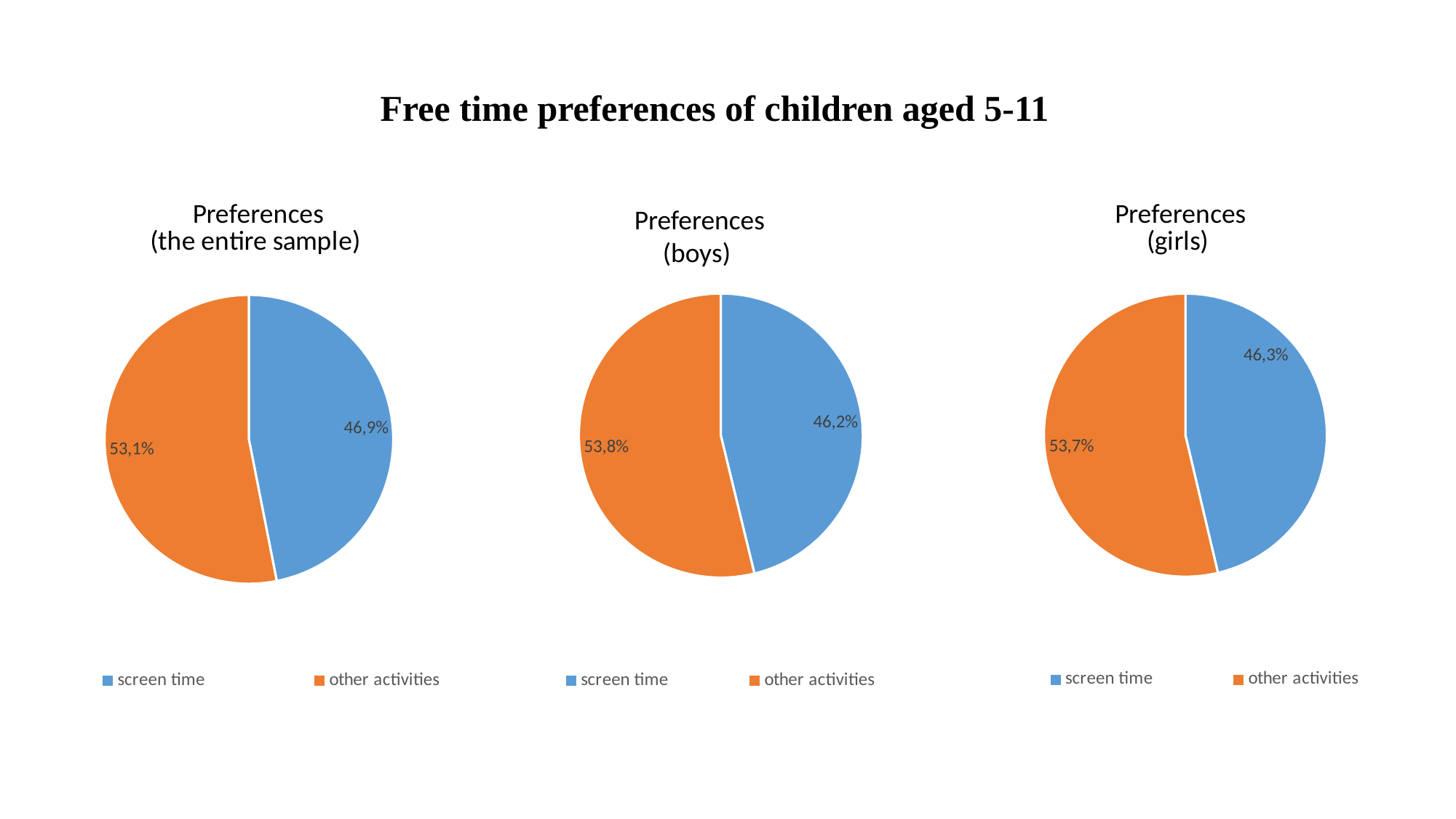
In the 'Preferences (the entire sample)' chart, what share is labelled for other activities? 53,1% In the 'Preferences (girls)' chart, what share is labelled for screen time? 46,3% In the 'Preferences (girls)' chart, which category has the smallest slice? screen time In the 'Preferences (girls)' chart, what share is labelled for other activities? 53,7% In the 'Preferences (boys)' chart, which slice is larger, screen time or other activities? other activities How many slices does the 'Preferences (girls)' chart have? 2 In the 'Preferences (the entire sample)' chart, what share is labelled for screen time? 46,9% In the 'Preferences (the entire sample)' chart, what is the difference in percentage points between other activities and screen time? 6,2 In the 'Preferences (boys)' chart, what share is labelled for screen time? 46,2% What is the main title at the top of the slide? Free time preferences of children aged 5-11 In the 'Preferences (boys)' chart, what share is labelled for other activities? 53,8% What kind of chart is the 'Preferences (boys)' chart? pie chart